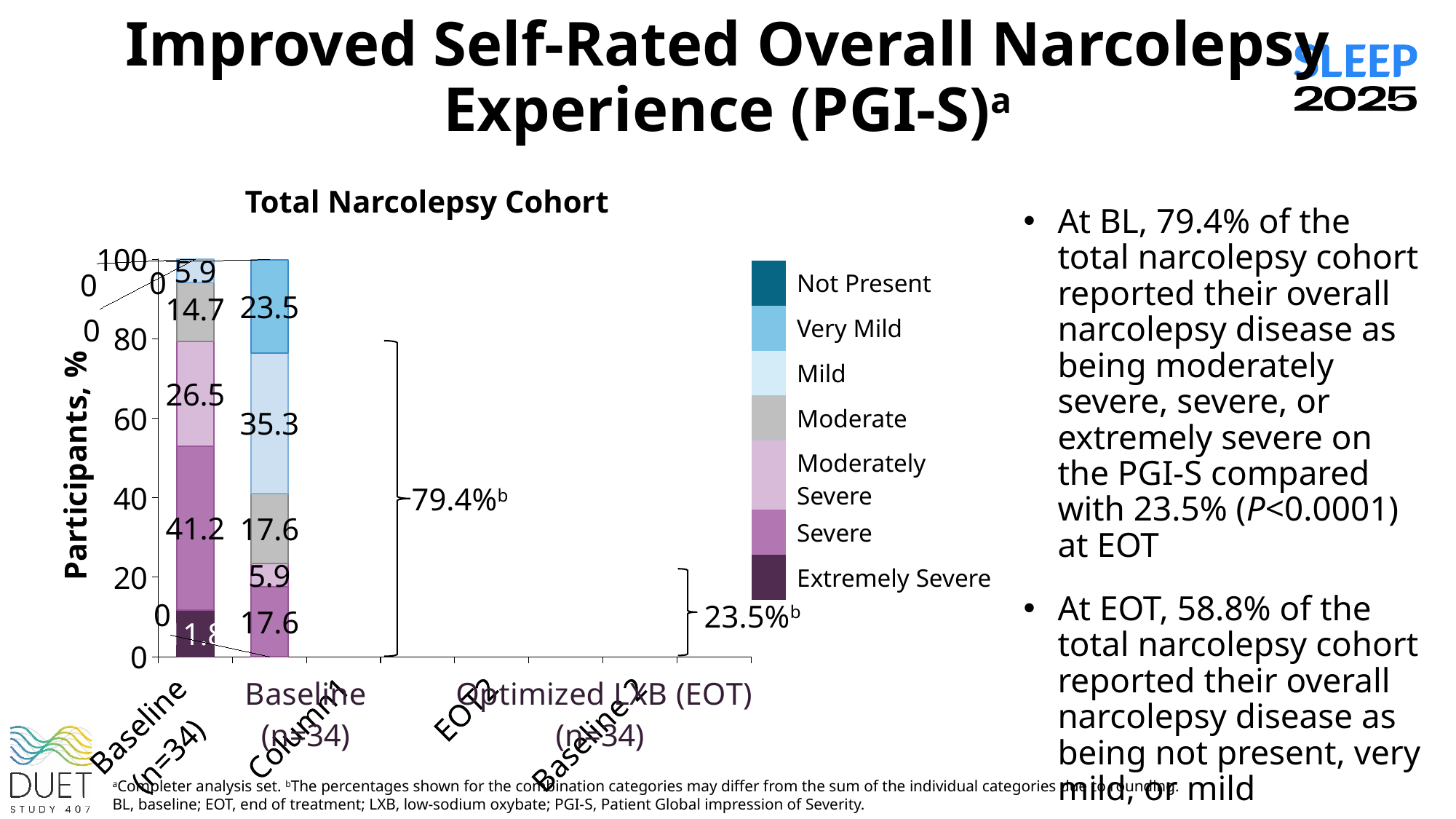
What is the title of the chart? Total Narcolepsy Cohort Which severity category has the largest segment in the Baseline bar? Severe How many stacked bars are plotted in the chart? 2 What type of chart is shown on the slide? Stacked bar chart What is the value for Very Mild in the Optimized LXB (EOT) bar? 23.5 How many severity categories does the legend list? 7 What is the difference between the Moderate values at Optimized LXB (EOT) and at Baseline? 2.9 What percentage of participants rated their narcolepsy as Mild at Optimized LXB (EOT)? 35.3 What is the value for Moderate in the Optimized LXB (EOT) bar? 17.6 What percentage of participants rated their narcolepsy as Severe at Baseline? 41.2 What is the value for Moderately Severe in the Baseline bar? 26.5 Which bar has the larger Severe segment, Baseline or Optimized LXB (EOT)? Baseline